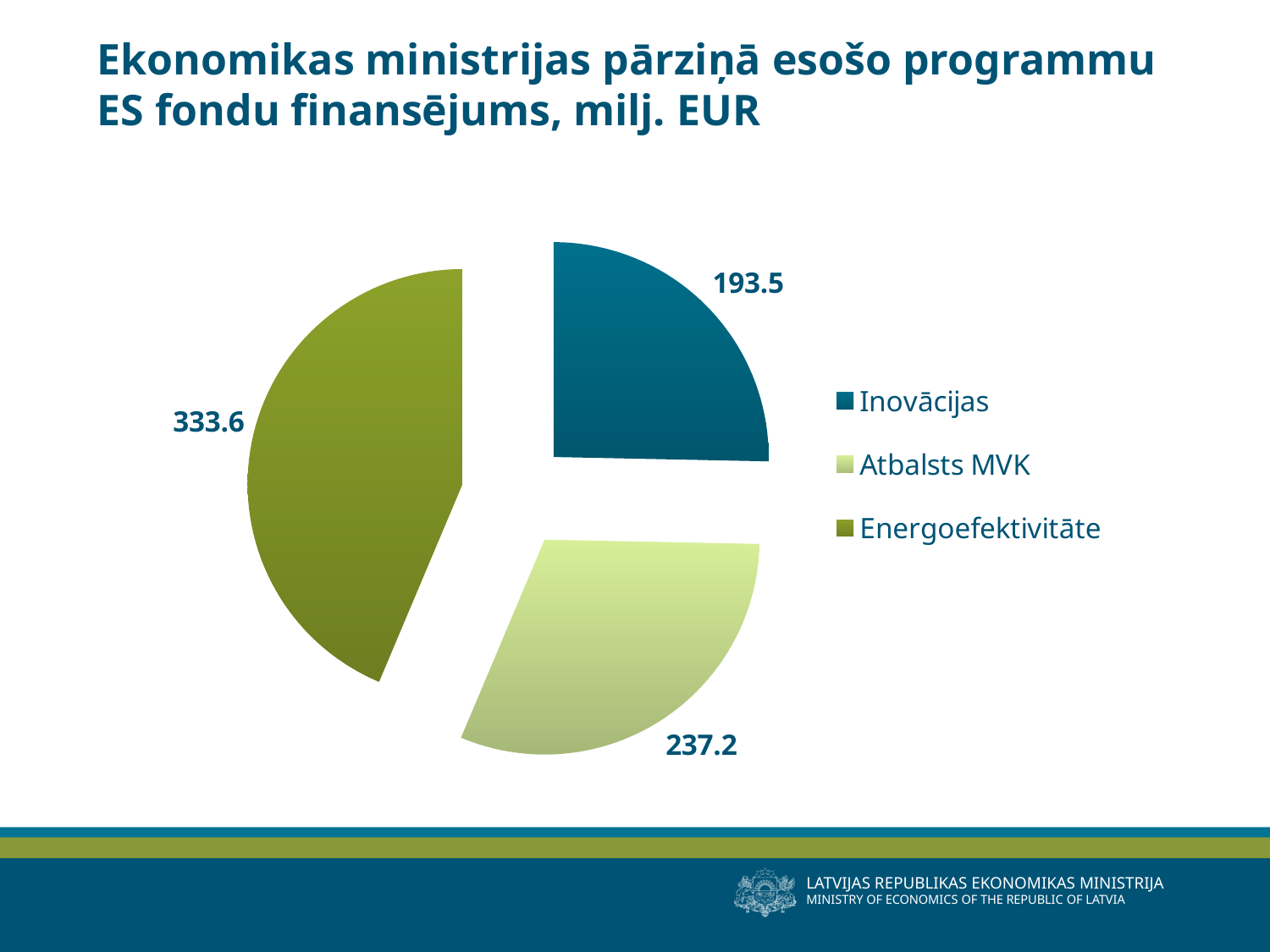
What type of chart is shown on the slide? pie chart What is the total of all three slices? 764.3 What is the title of the chart on the slide? Ekonomikas ministrijas pārziņā esošo programmu ES fondu finansējums, milj. EUR Which category has the largest value? Energoefektivitāte What is the value for Atbalsts MVK? 237.2 Which is larger, the value for Atbalsts MVK or the value for Inovācijas? Atbalsts MVK What is the value for Inovācijas? 193.5 Which category has the smallest value? Inovācijas How many slices does the pie chart have? 3 What is the difference between the values for Energoefektivitāte and Inovācijas? 140.1 What is the value for Energoefektivitāte? 333.6 What is the difference between the values for Atbalsts MVK and Inovācijas? 43.7